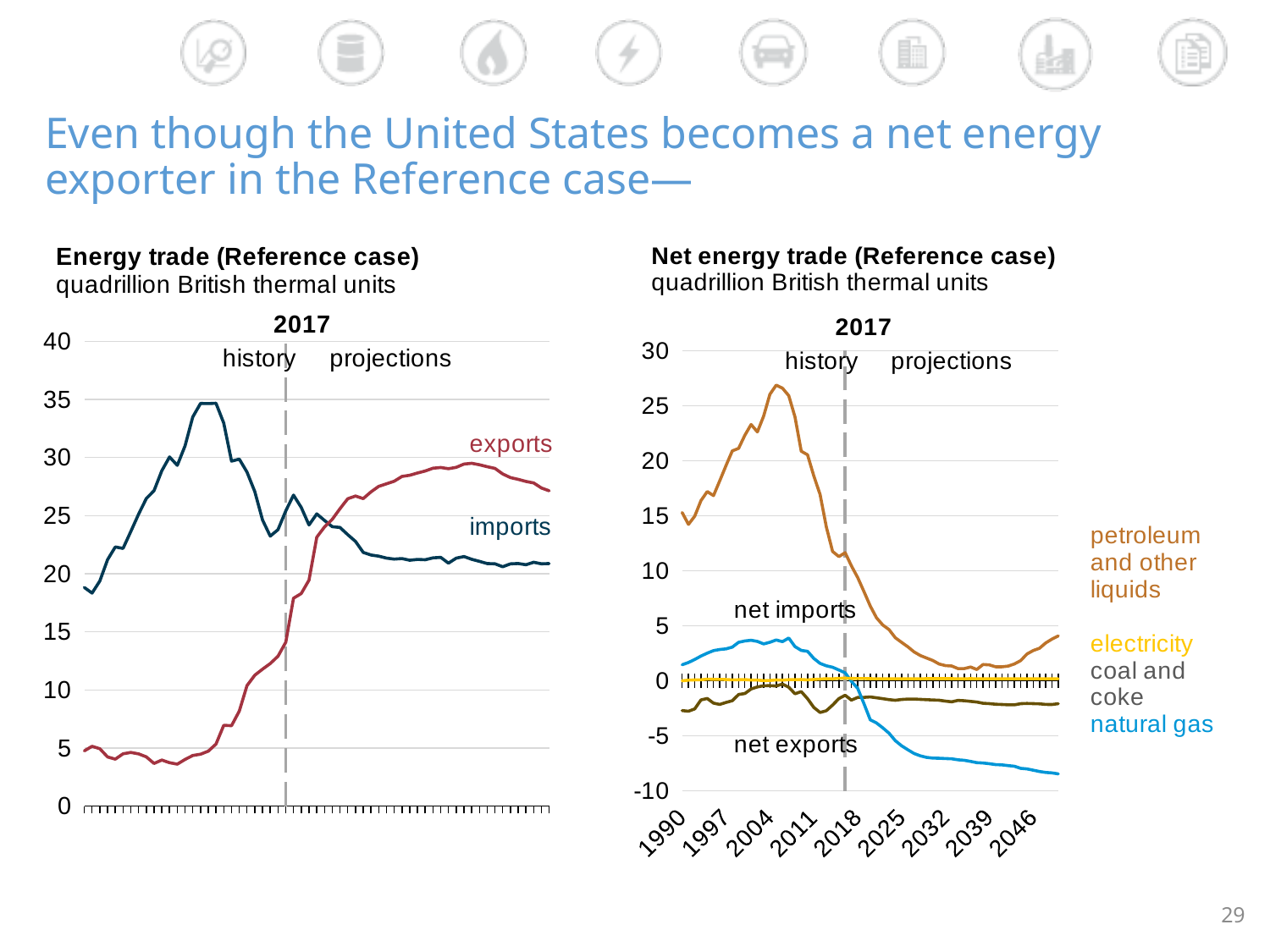
On the 'Net energy trade (Reference case)' chart, which series has the lowest value at the end of the projection period? natural gas On the 'Energy trade (Reference case)' chart, which series is higher at the end of the projection period, exports or imports? exports On the 'Energy trade (Reference case)' chart, is the peak value of imports greater or less than 30? greater On the 'Net energy trade (Reference case)' chart, does the petroleum and other liquids line rise or fall between 1990 and 2004? rise On the 'Net energy trade (Reference case)' chart, does the natural gas line rise or fall over the projection period? fall On the 'Net energy trade (Reference case)' chart, is the peak value of petroleum and other liquids greater or less than 25? greater On the 'Energy trade (Reference case)' chart, is the value for exports in 2017 greater or less than 20? less What year does the dashed vertical line separating history from projections mark on both charts? 2017 On the 'Net energy trade (Reference case)' chart, which series has the highest value in 2017? petroleum and other liquids How many series are plotted on the 'Energy trade (Reference case)' chart on the left? 2 How many series are listed in the legend of the 'Net energy trade (Reference case)' chart on the right? 4 What kind of chart is the 'Energy trade (Reference case)' chart on the left? line chart